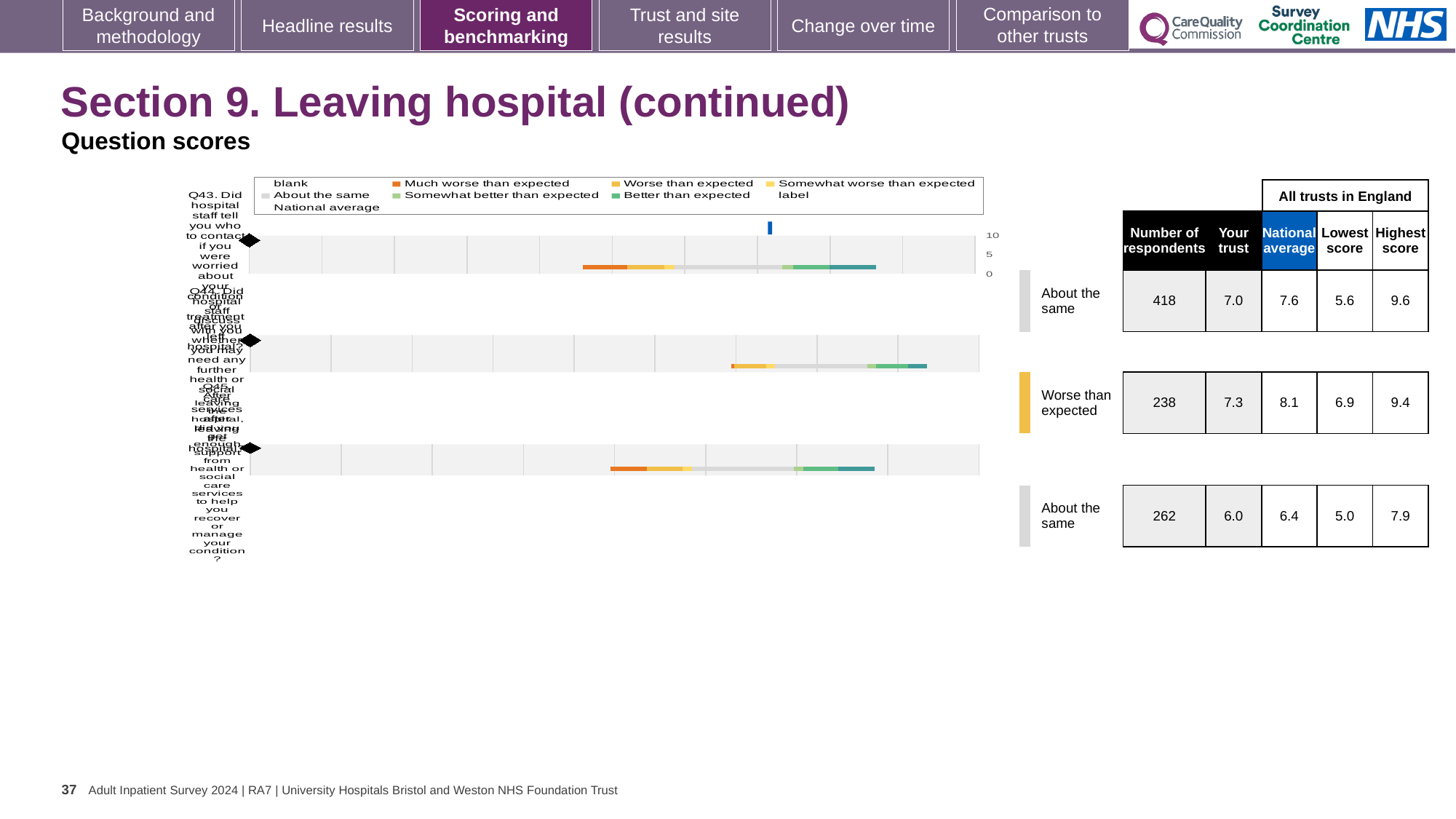
Which legend entry is shown in dark orange in the chart? Much worse than expected In the table beside the chart, how many respondents are listed for the third row (Q45)? 262 How many entries does the chart legend list? 9 In the table beside the chart, is the 'Your trust' score for the third row (Q45) larger or smaller than its national average? Smaller In the table beside the chart, what is the 'Your trust' score for the first row (Q43, About the same)? 7.0 What kind of chart is shown on the slide? Bar chart In the table beside the chart, which row has the highest 'Highest score' value? Q43 (About the same), 9.6 How many question bars are plotted in the chart? 3 In the table beside the chart, what is the difference between the national average and 'Your trust' score for the second row (Q44)? 0.8 In the table beside the chart, what is the national average for the second row (Q44, Worse than expected)? 8.1 What is the highest tick value shown on the chart's axis? 10